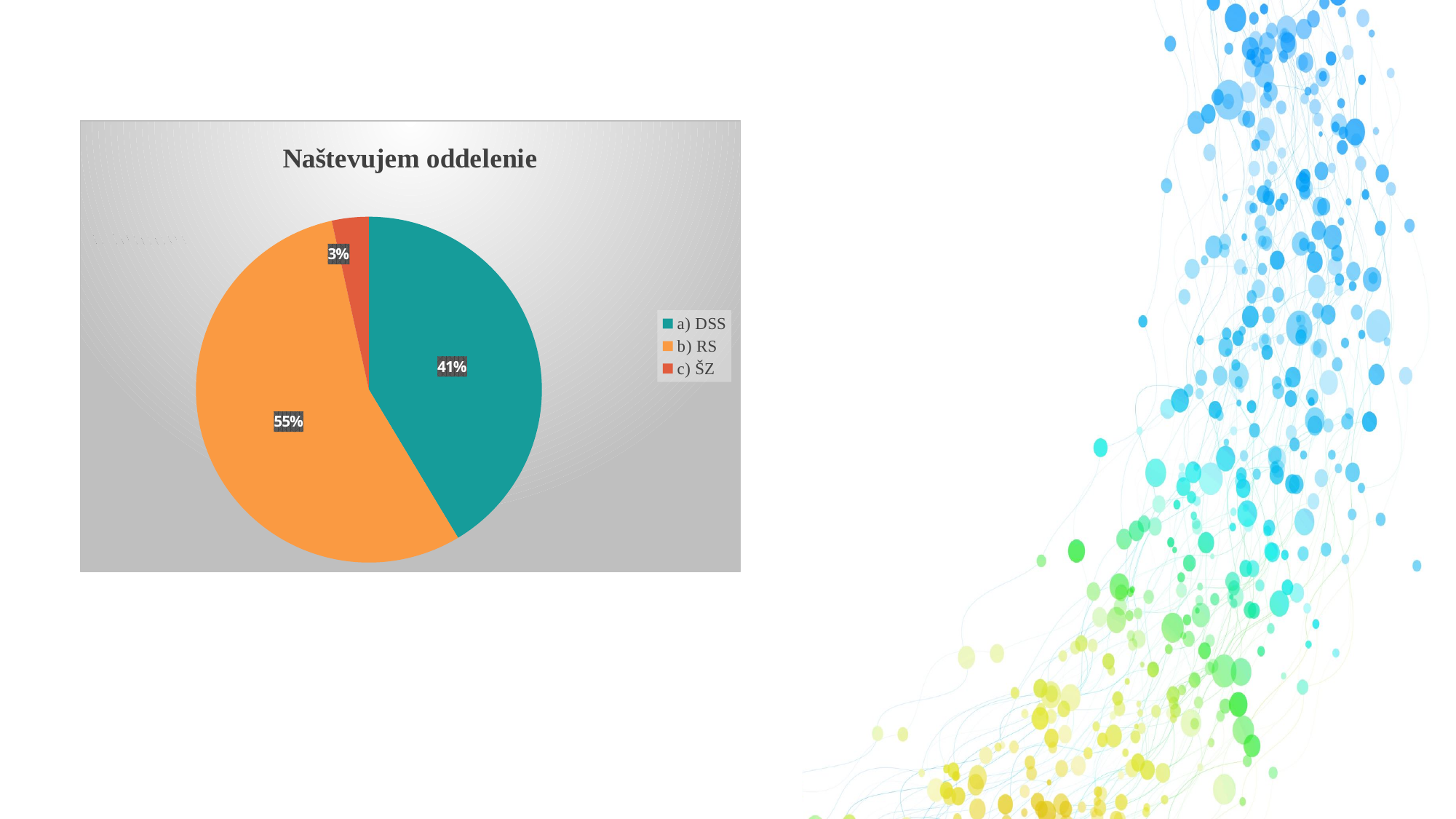
How many categories does the pie chart have? 3 Which is larger, the slice for a) DSS or the slice for c) ŠZ? a) DSS What is the difference in percentage points between b) RS and a) DSS? 14 Which category has the largest slice of the pie? b) RS Which category has the smallest slice of the pie? c) ŠZ What kind of chart is shown on the slide? pie chart What share of the pie does c) ŠZ have? 3% What share of the pie does a) DSS have? 41% What share of the pie does b) RS have? 55% What colour is the slice for b) RS? orange What is the title of the chart? Naštevujem oddelenie What is the difference in percentage points between a) DSS and c) ŠZ? 38